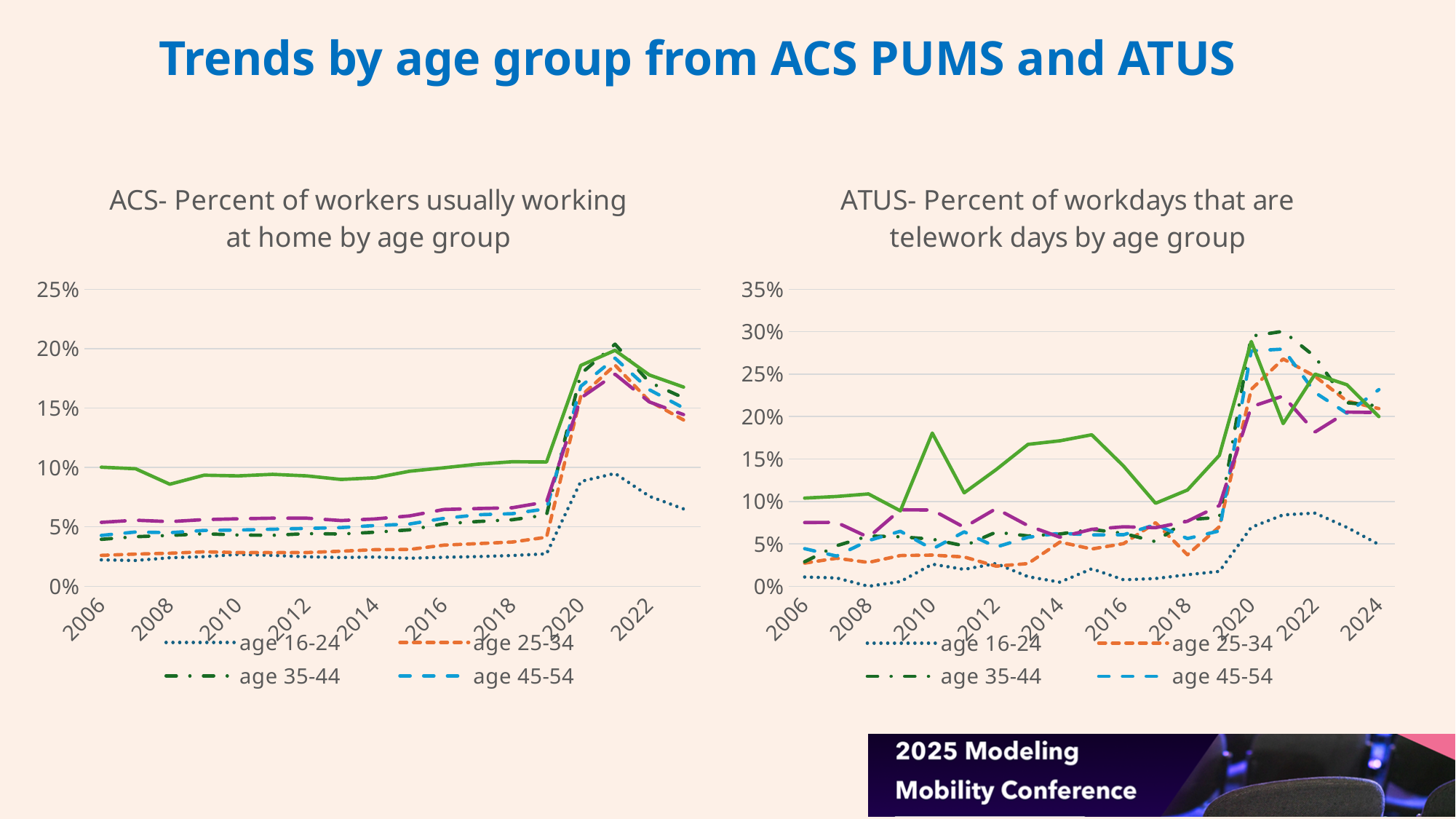
In the ACS chart on the left, does the age 25-34 line rise or fall between 2019 and 2020? rise In the ATUS chart on the right, is the value for age 16-24 in 2008 greater or less than 5%? less What is the title of the chart on the right? ATUS- Percent of workdays that are telework days by age group How many series does the legend of the ATUS chart on the right list? 4 How many year labels are shown on the x axis of the ATUS chart on the right? 10 What kind of chart is the ACS chart on the left? line chart In the ACS chart on the left, which legend series has the lowest value in 2006? age 16-24 In the ACS chart on the left, is the value for age 16-24 in 2006 greater or less than 5%? less In the ATUS chart on the right, is the value for age 35-44 in 2021 greater or less than 25%? greater In the ATUS chart on the right, which legend series has the highest value in 2021? age 35-44 In the ACS chart on the left, which is larger in 2006: age 45-54 or age 16-24? age 45-54